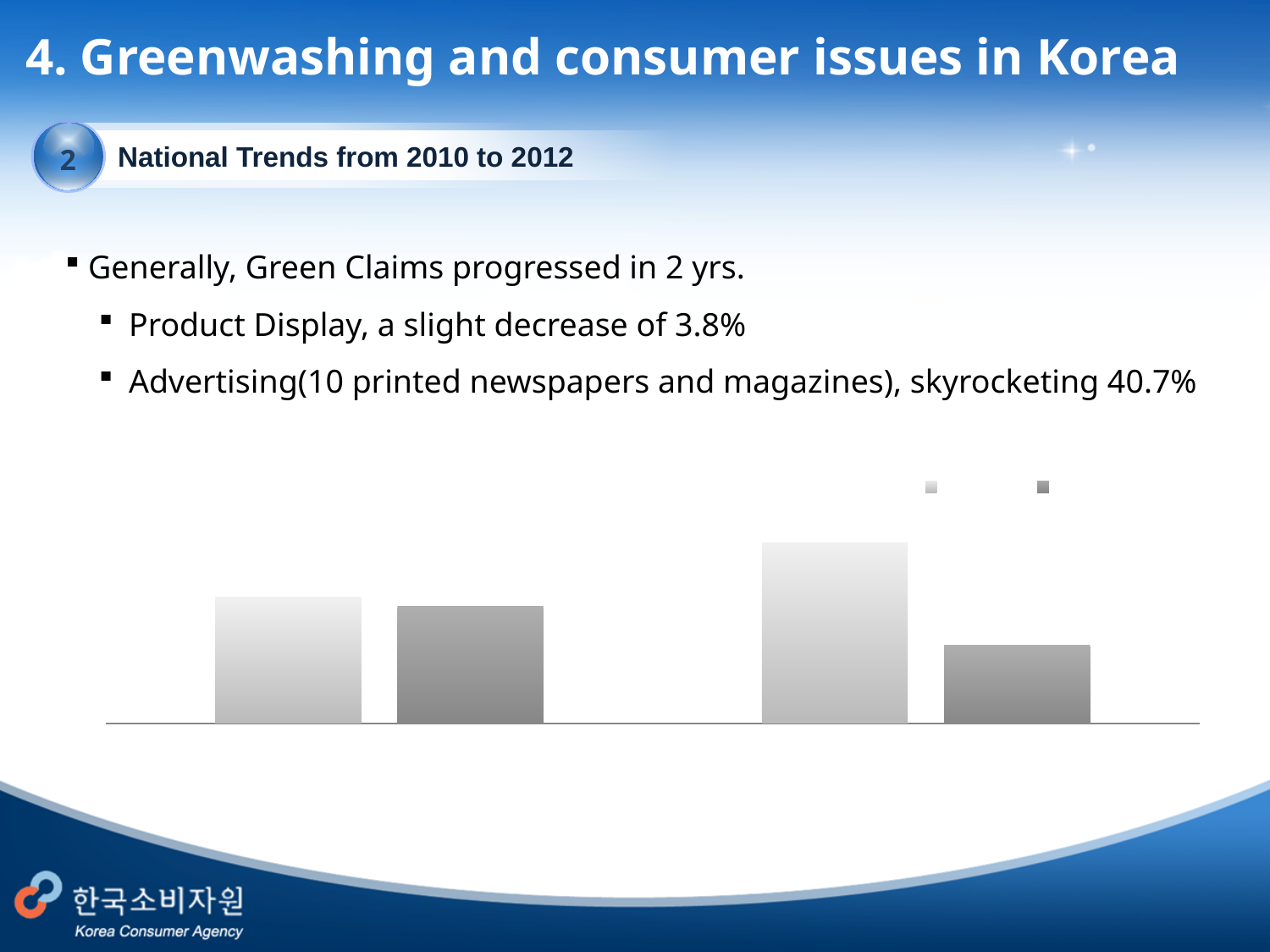
Does the chart display any data labels on its bars? No In the right-hand group of bars, is the lighter bar or the darker bar taller? the lighter bar How many bars are plotted in the chart? 4 What kind of chart is shown on the slide? bar chart How many groups of bars are shown in the chart? 2 Which bar in the chart is the tallest: the lighter bar of the left group or the lighter bar of the right group? the lighter bar of the right group How many series does the chart's legend list? 2 In the left-hand group of bars, is the lighter bar or the darker bar taller? the lighter bar